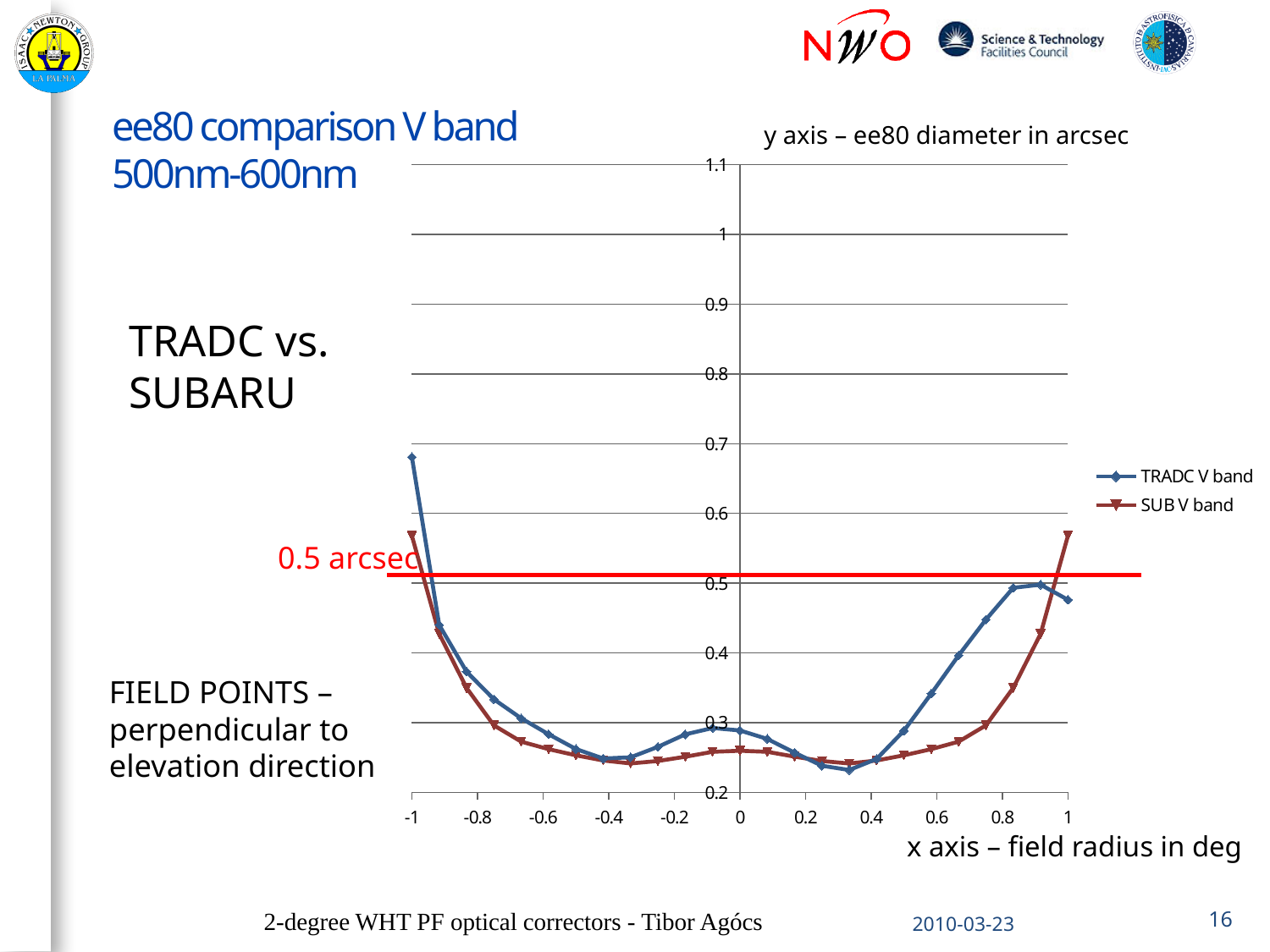
At field radius 0.8, which series has the higher value, TRADC V band or SUB V band? TRADC V band What kind of chart is shown on the slide? line chart Is the TRADC V band value at field radius -1 greater or less than 0.6? greater How many series does the legend list? 2 Is the SUB V band value at field radius 1 greater or less than 0.5? greater Is the SUB V band value at field radius -1 greater or less than 0.5? greater At field radius -1, which series has the higher value, TRADC V band or SUB V band? TRADC V band At field radius 1, which series has the higher value, TRADC V band or SUB V band? SUB V band What quantity does the y axis represent, according to the slide? ee80 diameter in arcsec What are the two series named in the legend? TRADC V band and SUB V band Does the SUB V band series rise or fall as the field radius goes from 0.4 to 1? rise